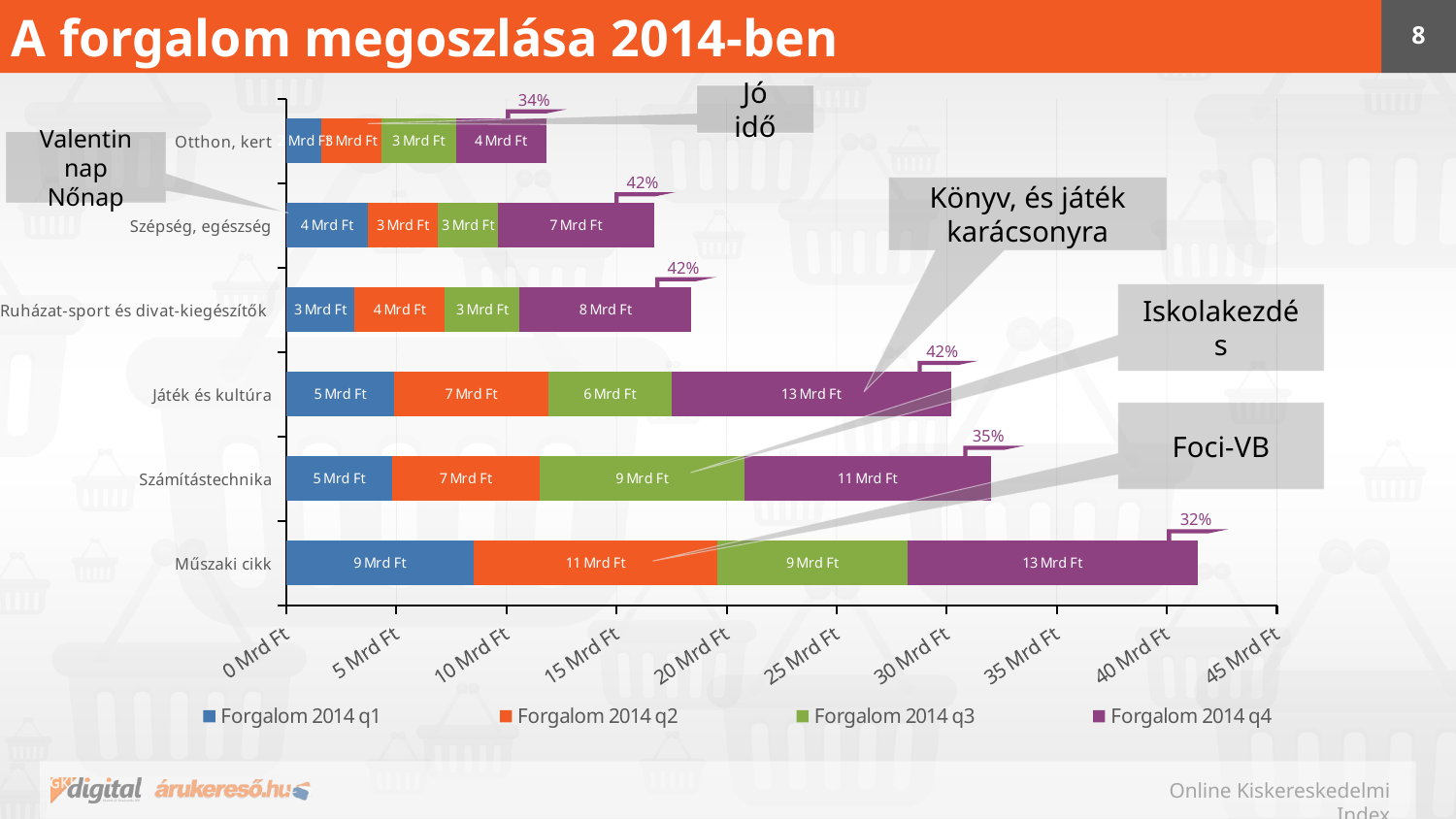
What is the total of the stacked bar for Szépség, egészség? 17 Mrd Ft For Játék és kultúra, how much larger is Forgalom 2014 q4 than Forgalom 2014 q1? 8 Mrd Ft How many categories are shown on the chart? 6 How many series does the legend list? 4 Which category has the longest total stacked bar? Műszaki cikk What is the total of the stacked bar for Műszaki cikk? 42 Mrd Ft What is the value of Forgalom 2014 q3 for Számítástechnika? 9 Mrd Ft What is the value of Forgalom 2014 q2 for Játék és kultúra? 7 Mrd Ft Which category has the shortest total stacked bar? Otthon, kert Which is larger: Forgalom 2014 q4 for Ruházat-sport és divat-kiegészítők or for Szépség, egészség? Ruházat-sport és divat-kiegészítők What is the value of Forgalom 2014 q4 for Műszaki cikk? 13 Mrd Ft Is the total stacked bar for Számítástechnika greater or less than 30 Mrd Ft? greater